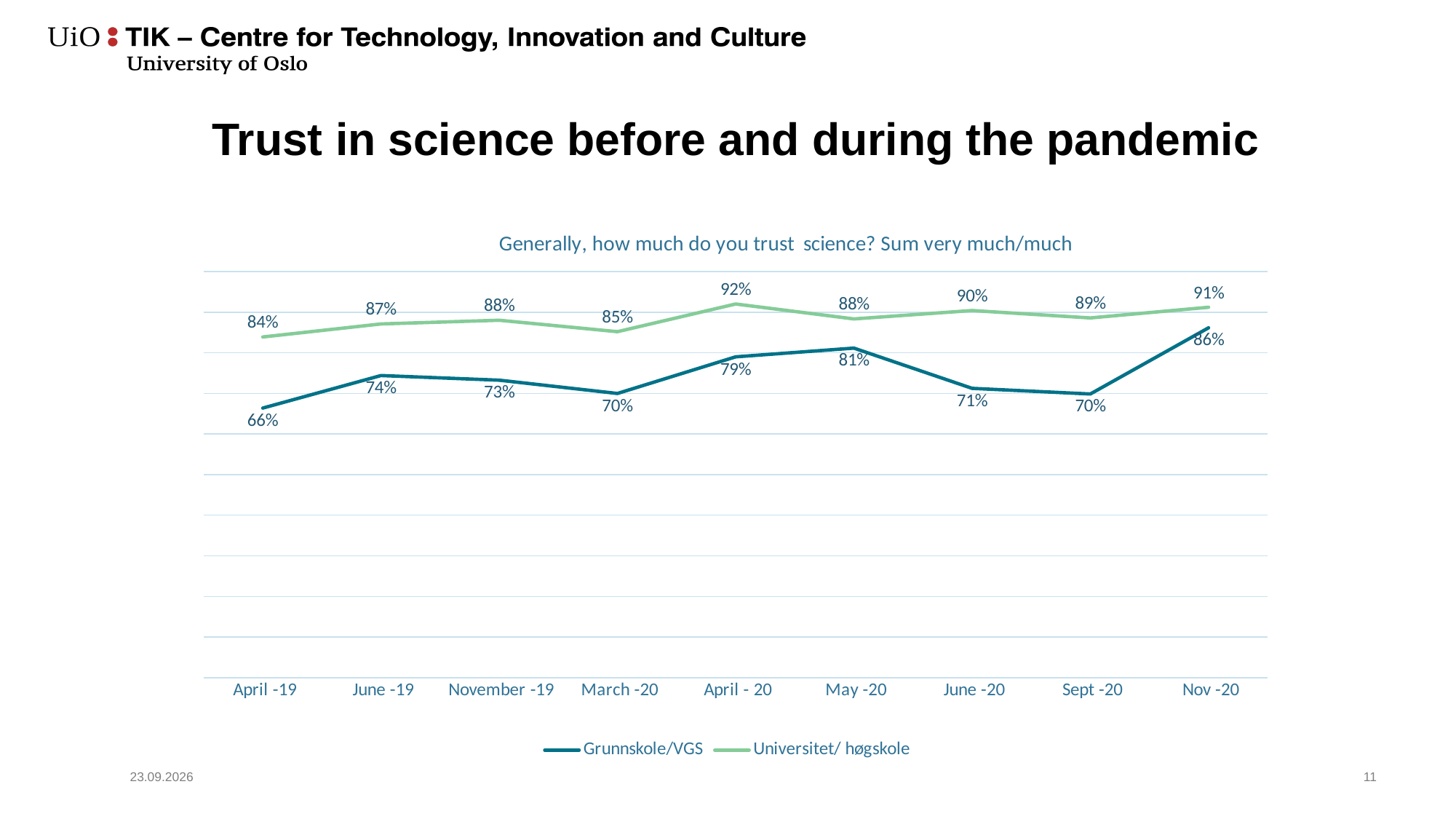
What is the value for Grunnskole/VGS in April -19? 66% In which period is the Universitet/ høgskole value highest? April - 20 How many time periods are shown on the x axis? 9 Which series has the higher value in May -20, Grunnskole/VGS or Universitet/ høgskole? Universitet/ høgskole What kind of chart is shown on the slide? Line chart What is the title of the chart? Generally, how much do you trust science? Sum very much/much How many series does the legend list? 2 Does the Grunnskole/VGS value rise or fall from Sept -20 to Nov -20? Rise In which period is the Grunnskole/VGS value lowest? April -19 What is the value for Grunnskole/VGS in Nov -20? 86% What is the difference between the Universitet/ høgskole and Grunnskole/VGS values in March -20? 15% What is the value for Universitet/ høgskole in April - 20? 92%